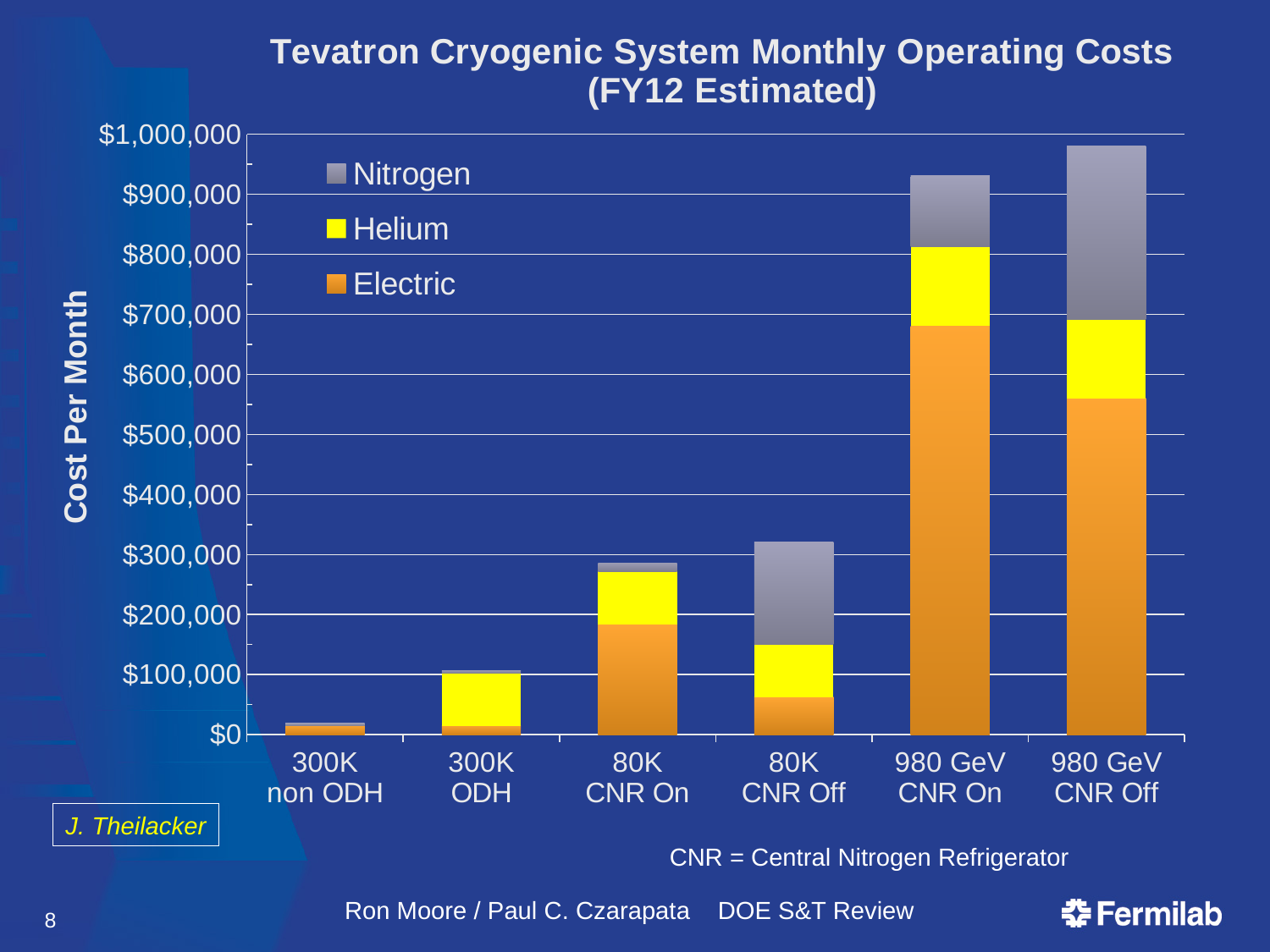
Do the total monthly costs rise or fall moving left to right along the x axis? rise Is the total monthly cost for 80K CNR Off greater or less than $300,000? greater What kind of chart is shown on the slide? Stacked bar chart How many categories are shown along the x axis? 6 Which has the larger total monthly cost, 80K CNR On or 80K CNR Off? 80K CNR Off Is the total monthly cost for 980 GeV CNR On greater or less than $900,000? greater Is the Electric cost for 980 GeV CNR Off greater or less than $600,000? less Which category has the lowest total monthly cost? 300K non ODH Which category has the highest total monthly cost? 980 GeV CNR Off Which has the larger Electric cost, 980 GeV CNR On or 980 GeV CNR Off? 980 GeV CNR On What is the label on the y axis of the chart? Cost Per Month How many series does the legend list? 3